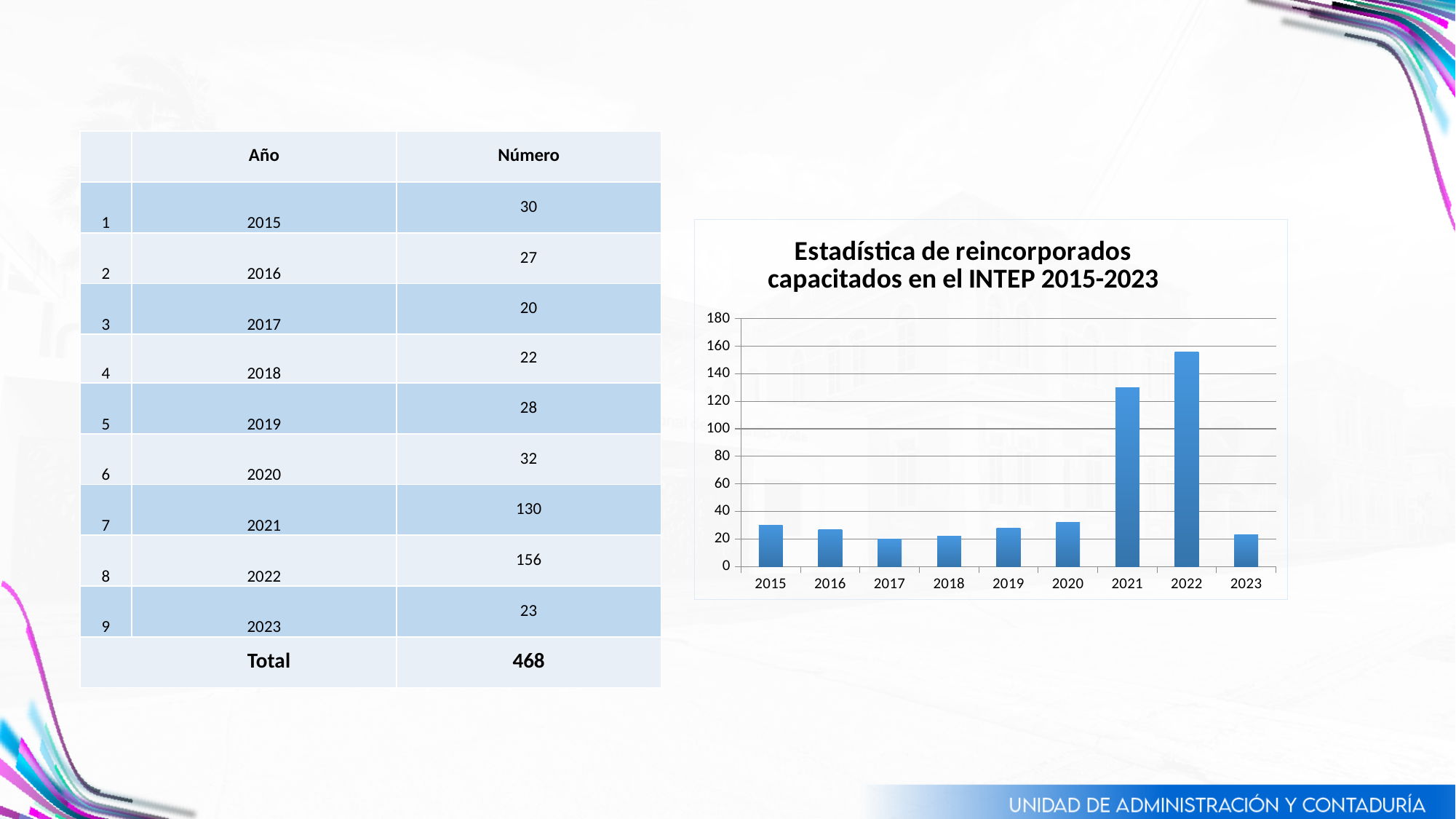
Is the value for 2021 greater or less than 120? greater Is the value for 2017 greater or less than 40? less Which year has the highest bar in the chart? 2022 According to the slide, what is the difference between the values for 2022 and 2021? 26 What is the title of the chart? Estadística de reincorporados capacitados en el INTEP 2015-2023 Which year has the lowest bar in the chart? 2017 Which is larger, the value for 2020 or the value for 2023? 2020 What kind of chart is shown on the slide? bar chart According to the slide, what is the value for 2021? 130 Which is larger, the value for 2021 or the value for 2022? 2022 How many years are plotted on the x axis of the chart? 9 Is the value for 2022 greater or less than 140? greater